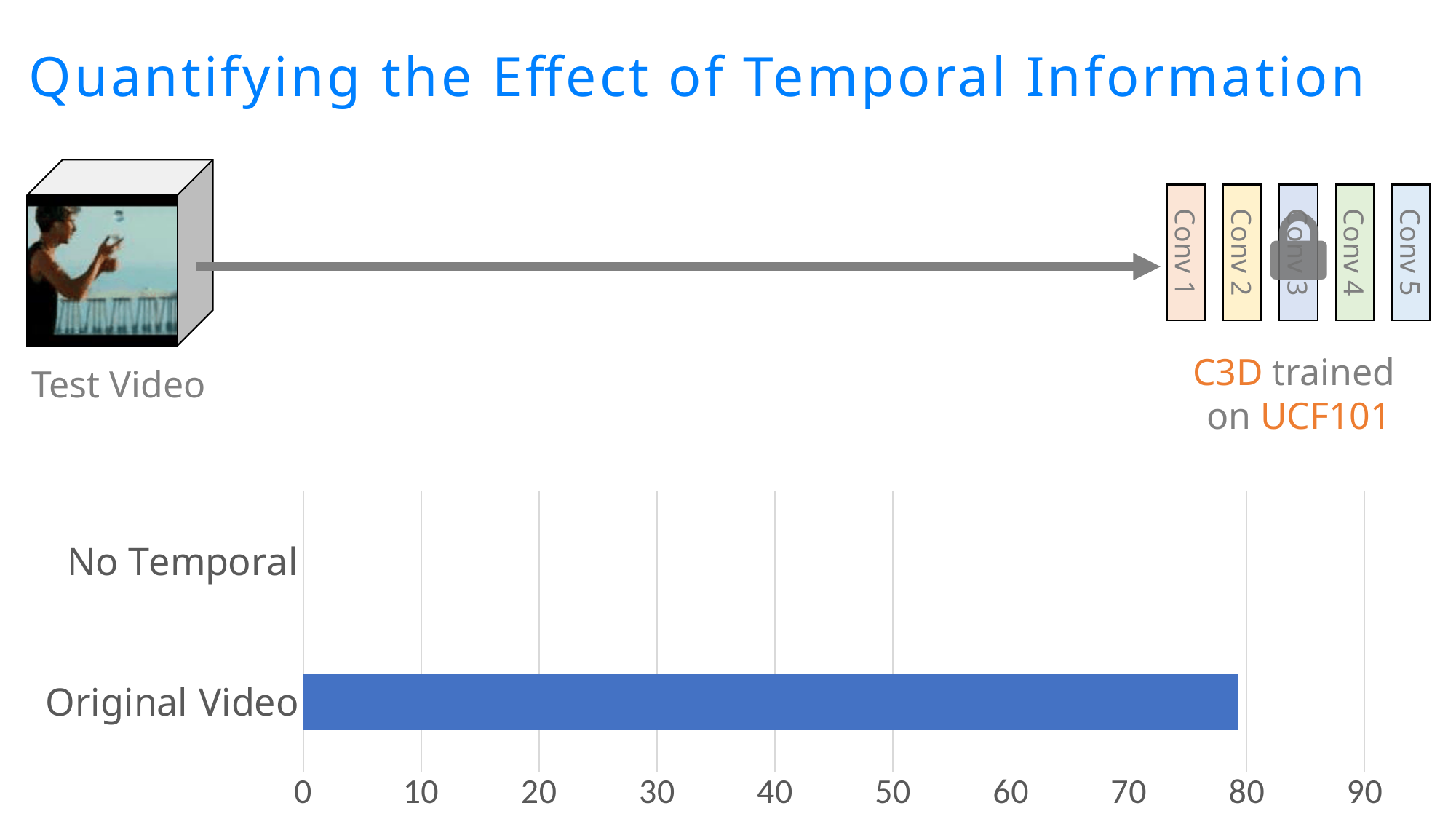
Which has the larger value, Original Video or No Temporal? Original Video Which category has the highest value in the chart? Original Video What is the title of the slide containing the chart? Quantifying the Effect of Temporal Information Is the value for Original Video greater or less than 50? greater What kind of chart is shown on the slide? bar chart Which category has the lowest value in the chart? No Temporal What is the highest tick value shown on the horizontal axis of the chart? 90 How many categories are listed on the vertical axis of the chart? 2 Is the value for Original Video greater or less than 90? less Is the value for Original Video greater or less than 70? greater